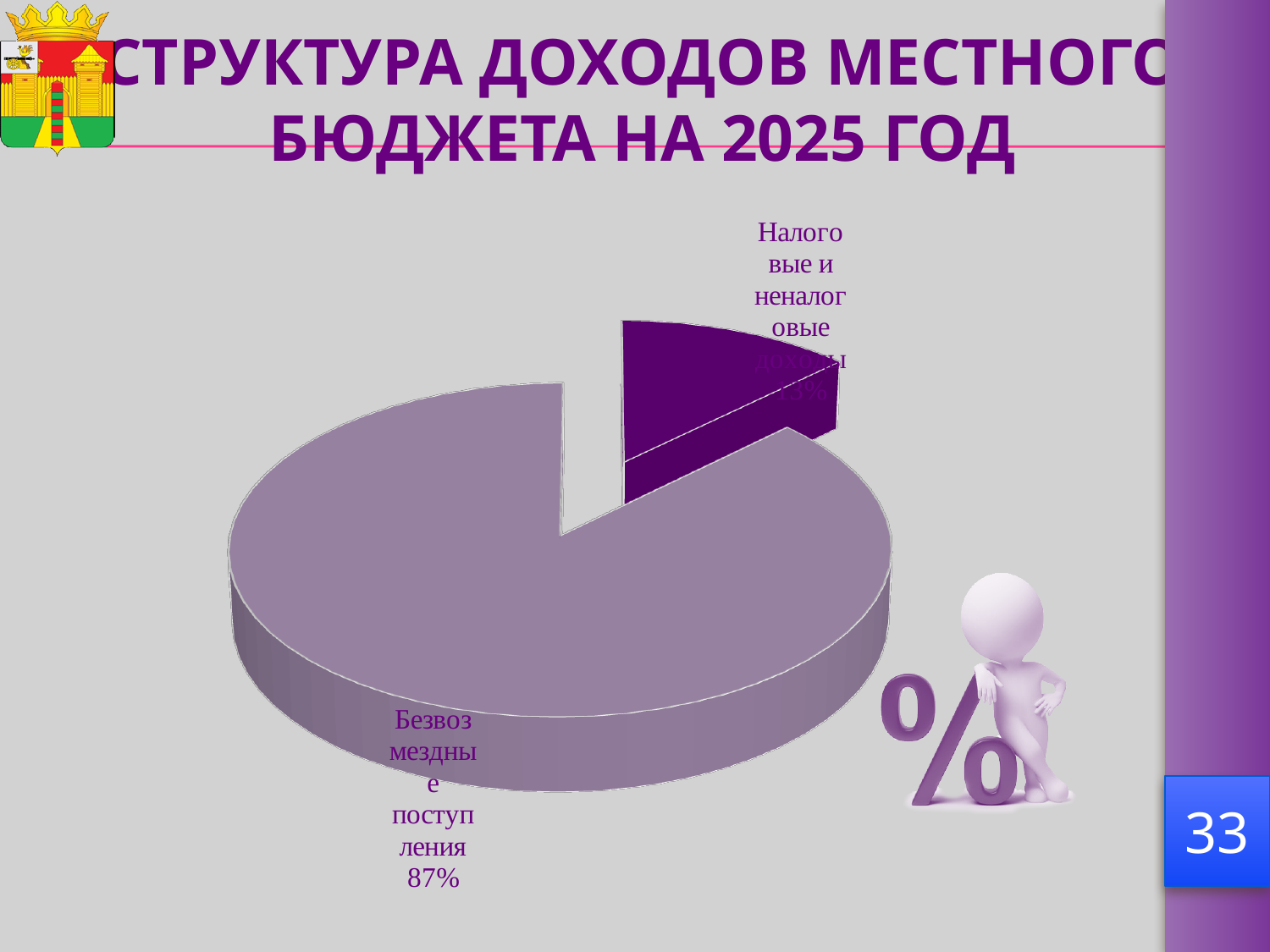
Which slice is pulled out (exploded) from the pie? Налоговые и неналоговые доходы Which slice of the pie is the smallest? Налоговые и неналоговые доходы What share of the pie is labelled for Налоговые и неналоговые доходы? 13% Which slice of the pie is the largest? Безвозмездные поступления Which is larger: Безвозмездные поступления or Налоговые и неналоговые доходы? Безвозмездные поступления What is the difference in percentage points between Безвозмездные поступления and Налоговые и неналоговые доходы? 74 What kind of chart is shown on the slide? Pie chart How many slices does the pie chart have? 2 What share of the pie is labelled for Безвозмездные поступления? 87% What is the title of the slide containing the chart? СТРУКТУРА ДОХОДОВ МЕСТНОГО БЮДЖЕТА НА 2025 ГОД